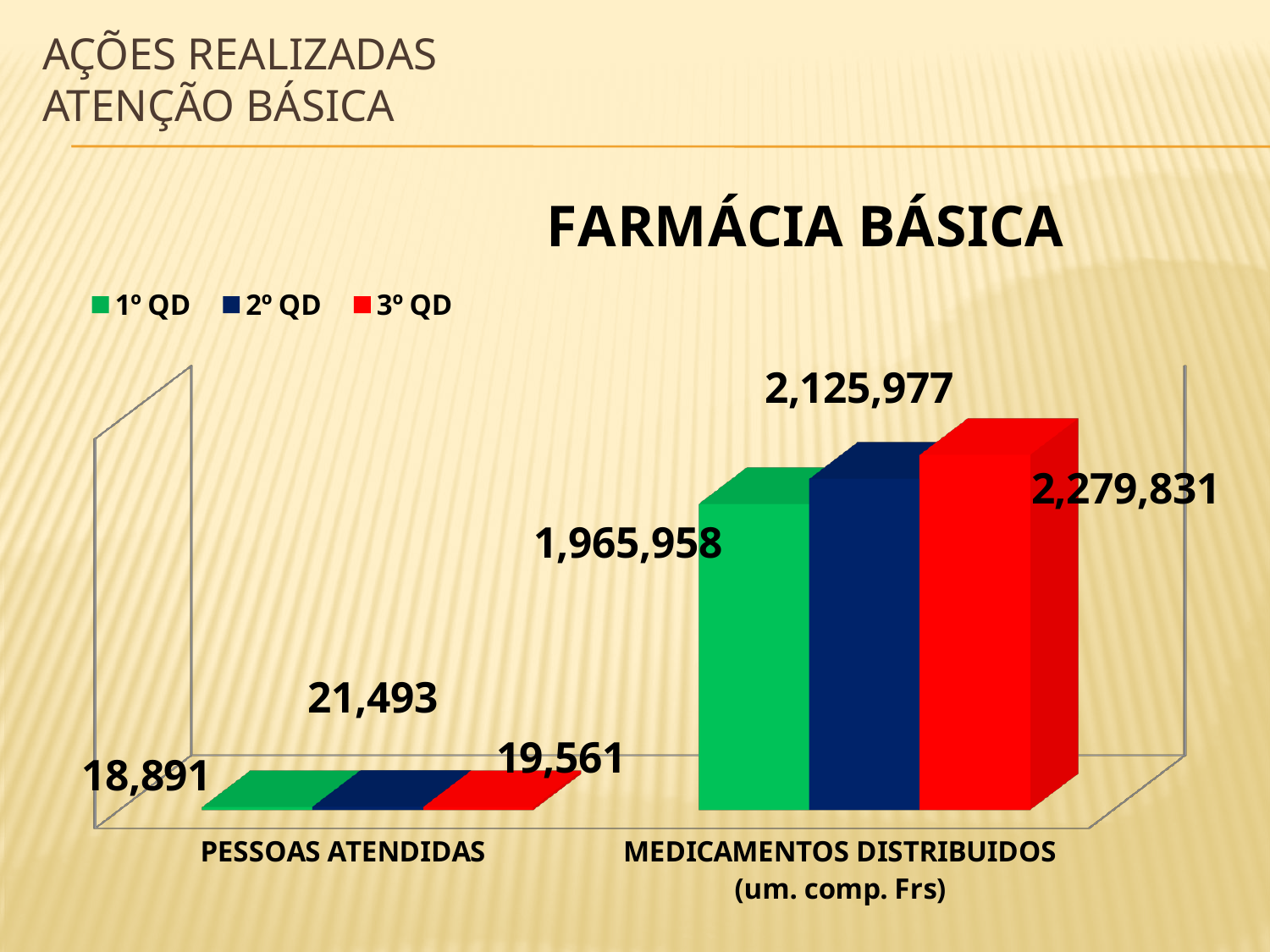
What is the value for 2º QD in PESSOAS ATENDIDAS? 21,493 How many categories are shown on the x axis? 2 Which series has the lowest value for PESSOAS ATENDIDAS? 1º QD Which colour represents the 2º QD series in the legend? dark blue What type of chart is shown on the slide? bar chart What is the value for 3º QD in MEDICAMENTOS DISTRIBUIDOS (um. comp. Frs)? 2,279,831 How many series does the legend list? 3 What is the value for 1º QD in MEDICAMENTOS DISTRIBUIDOS (um. comp. Frs)? 1,965,958 Which series has the highest value for MEDICAMENTOS DISTRIBUIDOS (um. comp. Frs)? 3º QD What is the title of the chart? FARMÁCIA BÁSICA What is the difference between the 3º QD and 1º QD values for MEDICAMENTOS DISTRIBUIDOS (um. comp. Frs)? 313,873 What is the value for 1º QD in PESSOAS ATENDIDAS? 18,891